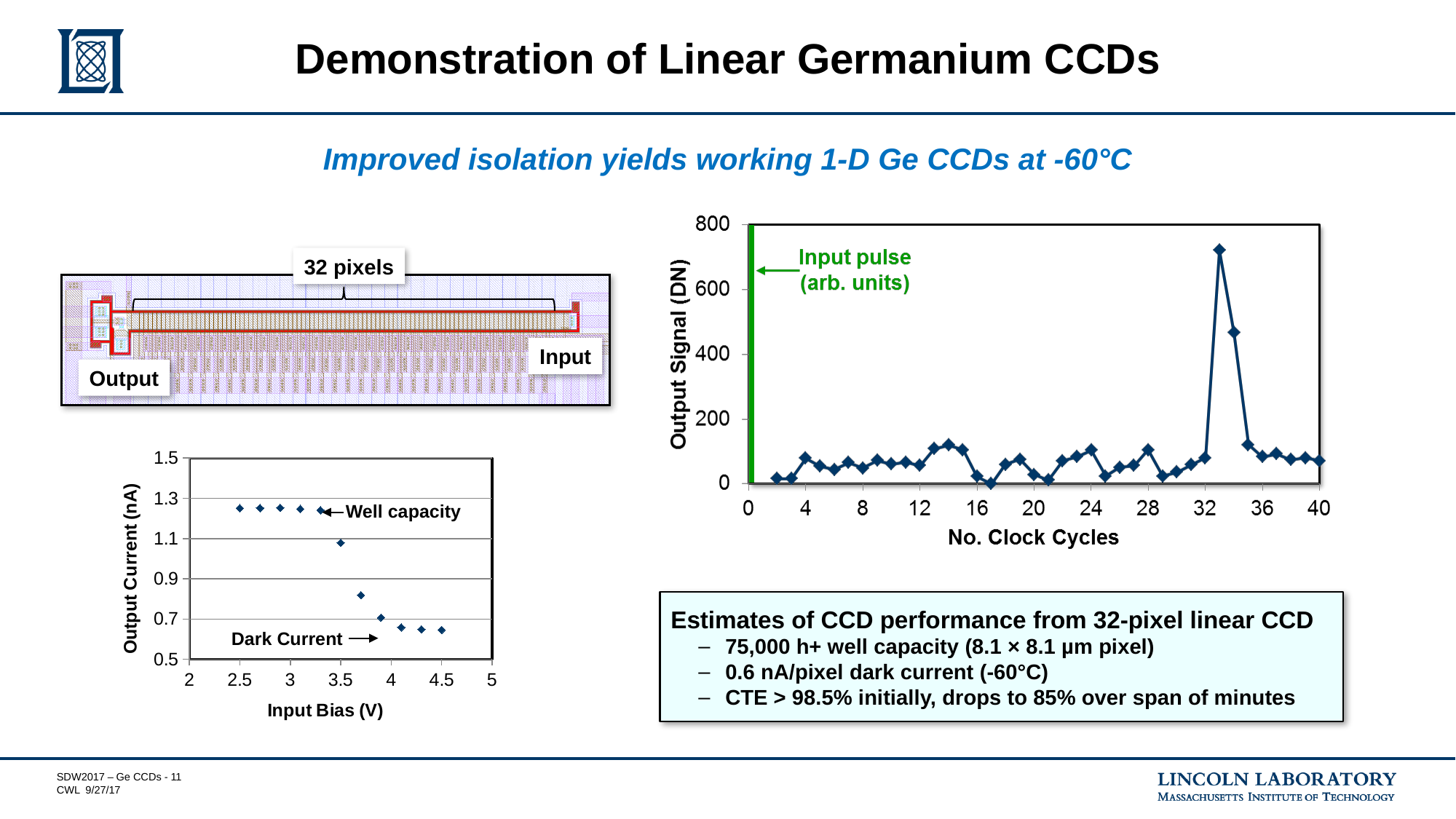
In the bottom-left chart, do the output current values rise or fall as the input bias increases? fall In the bottom-left chart, is the output current at an input bias of 4.5 V greater or less than 0.7 nA? less What kind of chart is the right-hand chart of Output Signal versus No. Clock Cycles? line chart In the right-hand chart, is the output signal at 20 clock cycles greater or less than 200 DN? less In the right-hand chart, is the output signal at 34 clock cycles greater or less than 400 DN? greater What is the x-axis label of the right-hand chart? No. Clock Cycles What does the green bar at the left edge of the right-hand chart represent, according to its annotation? Input pulse (arb. units) In the bottom-left chart, which is larger: the output current at 3.5 V or at 3.9 V input bias? 3.5 V What kind of chart is the bottom-left chart of Output Current versus Input Bias? scatter chart